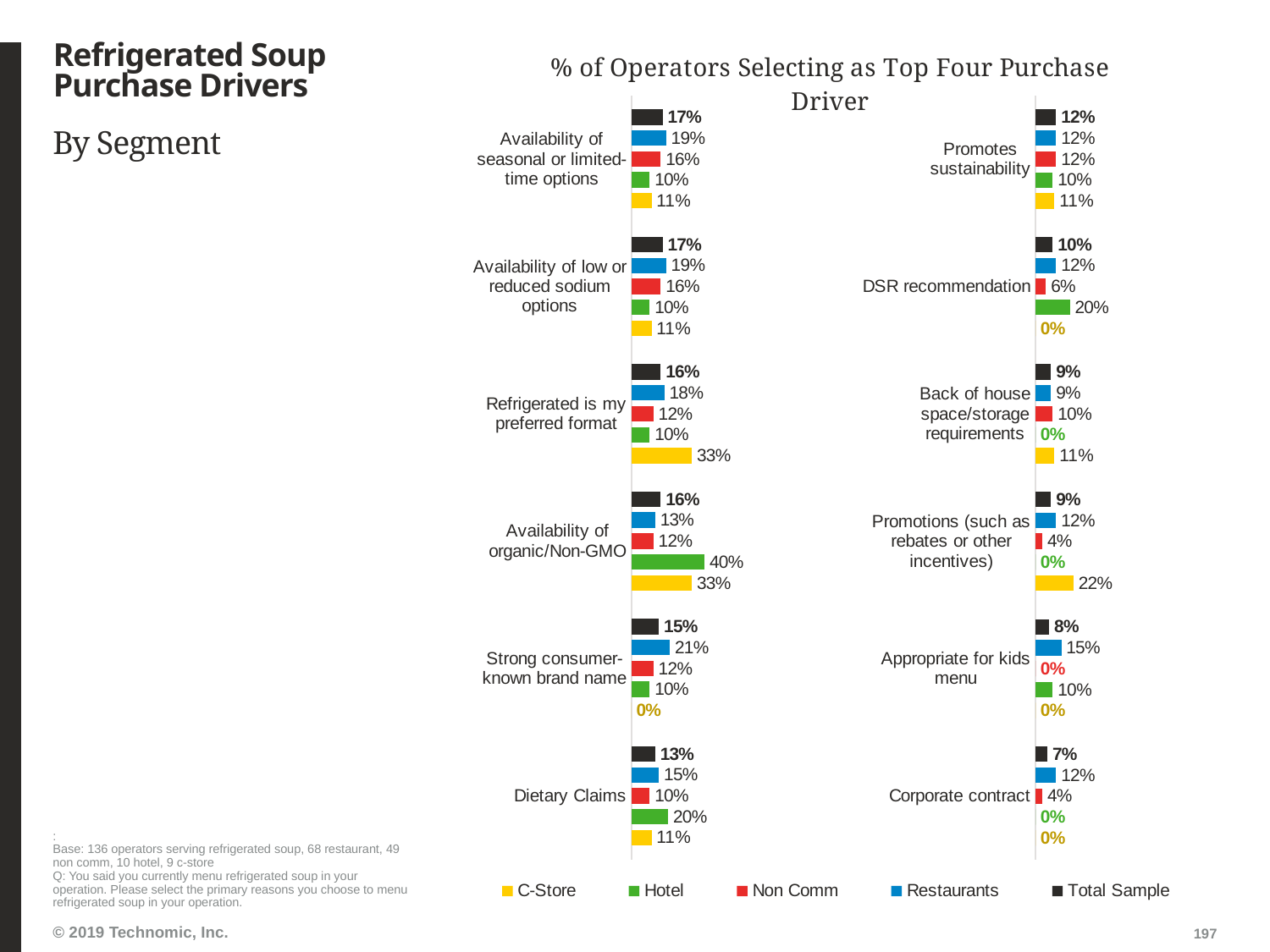
How many series does the legend list? 5 In the left chart, what percentage of the Total Sample selected 'Availability of seasonal or limited-time options'? 17% Which colour represents the Non Comm segment in the legend? Red In the right chart, what is the C-Store value for 'Promotions (such as rebates or other incentives)'? 22% In the left chart, which segment has the highest value for 'Strong consumer-known brand name'? Restaurants In the right chart, which is larger for 'Appropriate for kids menu': the Restaurants value or the Hotel value? Restaurants In the left chart, what is the Hotel value for 'Availability of organic/Non-GMO'? 40% In the right chart, what is the Hotel value for 'DSR recommendation'? 20% What type of chart is used on this slide? Bar chart In the left chart, what is the difference between the Restaurants and Non Comm values for 'Refrigerated is my preferred format'? 6 percentage points In the right chart, which segment has the lowest value for 'Corporate contract'? Hotel and C-Store (both 0%) How many purchase drivers are shown in the left chart? 6